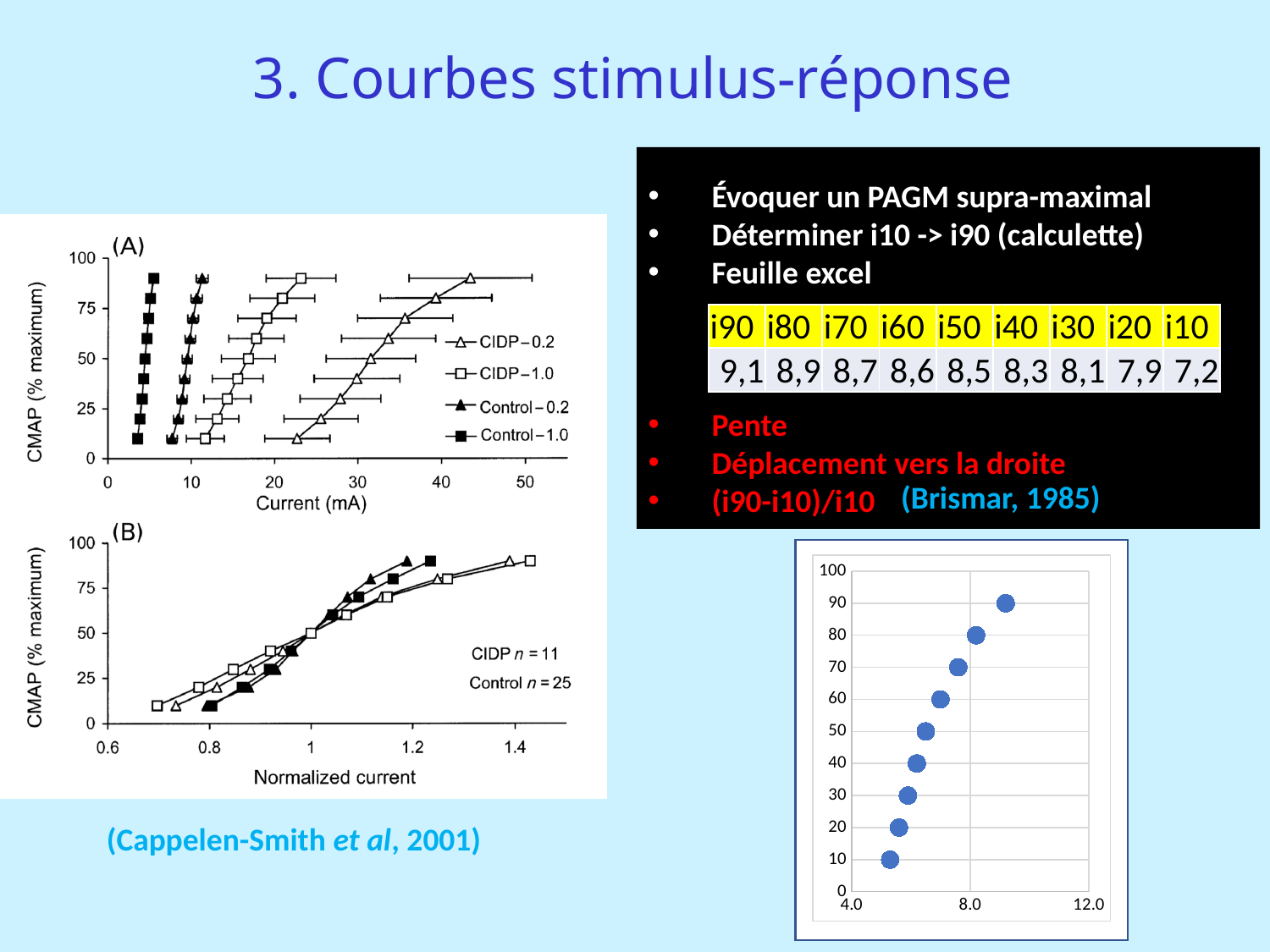
In the scatter chart at the bottom right, is the x value of the point at y = 90 greater or less than 8.0? greater In the scatter chart at the bottom right, what is the lowest y value reached by a plotted point? 10 In panel (A) of the chart on the left, which series extends to the highest current values? CIDP-0.2 In panel (A) of the chart on the left, what is the x-axis label? Current (mA) In panel (A) of the chart on the left, how many series does the legend list? 4 In panel (A) of the chart on the left, what are the legend entries? CIDP-0.2, CIDP-1.0, Control-0.2, Control-1.0 In the scatter chart at the bottom right, what is the highest y value reached by a plotted point? 90 What kind of chart is the chart at the bottom right of the slide? scatter chart In the scatter chart at the bottom right, do the y values rise or fall as the x values increase? rise How many data points are plotted in the scatter chart at the bottom right? 9 In the scatter chart at the bottom right, what is the largest tick value shown on the x axis? 12.0 In the scatter chart at the bottom right, is the x value of the point at y = 10 greater or less than 8.0? less